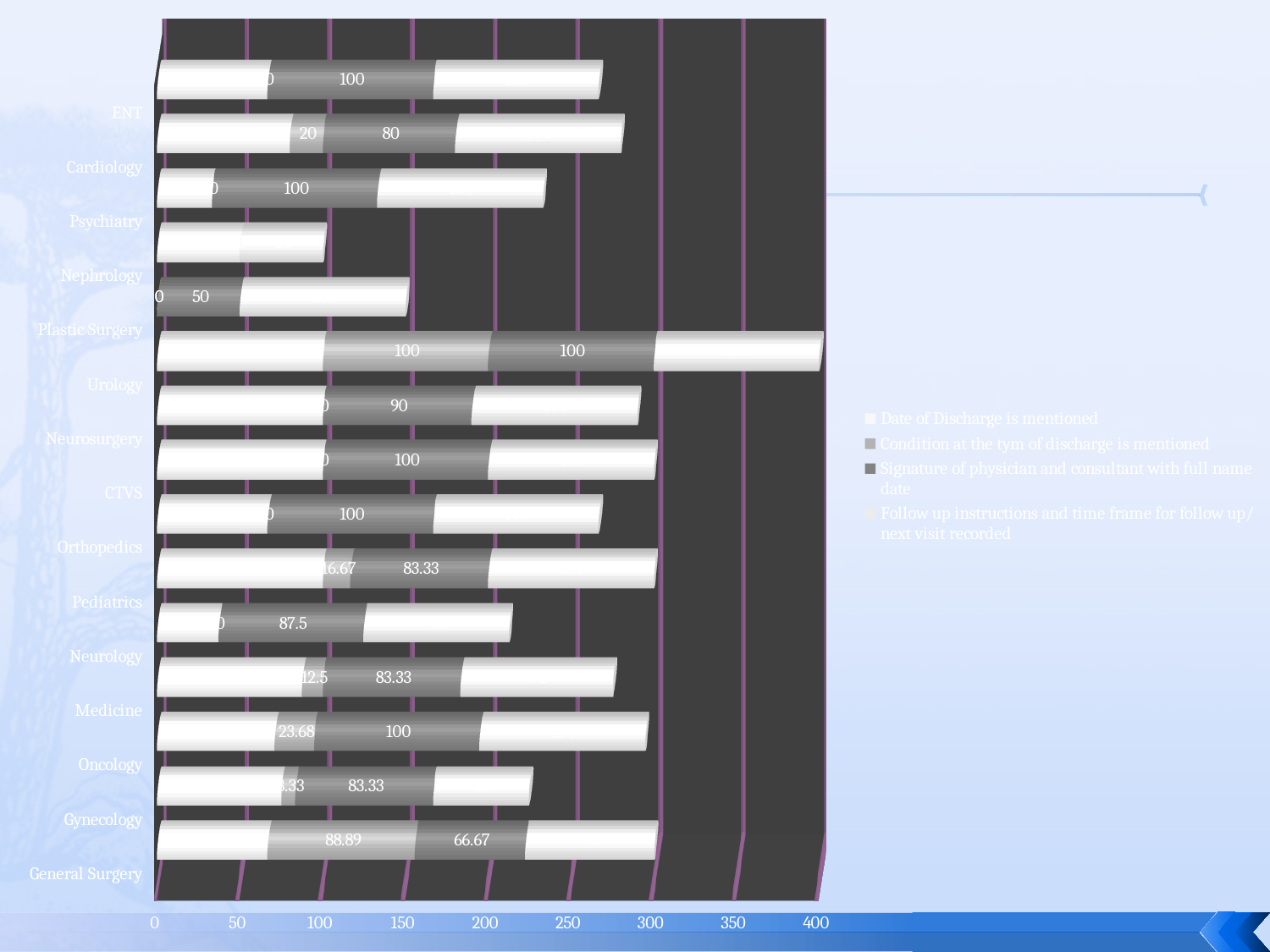
What is the value of 'Condition at the tym of discharge is mentioned' for Medicine? 12.5 How many series does the legend list? 4 What is the value of 'Condition at the tym of discharge is mentioned' for Oncology? 23.68 What is the value of 'Signature of physician and consultant with full name date' for Cardiology? 80 How many departments (categories) are plotted on the chart? 15 What is the value of 'Signature of physician and consultant with full name date' for General Surgery? 66.67 Which department has the shortest stacked bar overall? Nephrology Which is larger: the 'Signature of physician' value for Pediatrics or for Cardiology? Pediatrics Is the total stacked value for Urology greater or less than 350? greater Which department has the longest stacked bar overall? Urology What kind of chart is shown on the slide? bar chart For General Surgery, what is the difference between the 'Condition at the tym of discharge' value and the 'Signature of physician' value? 22.22